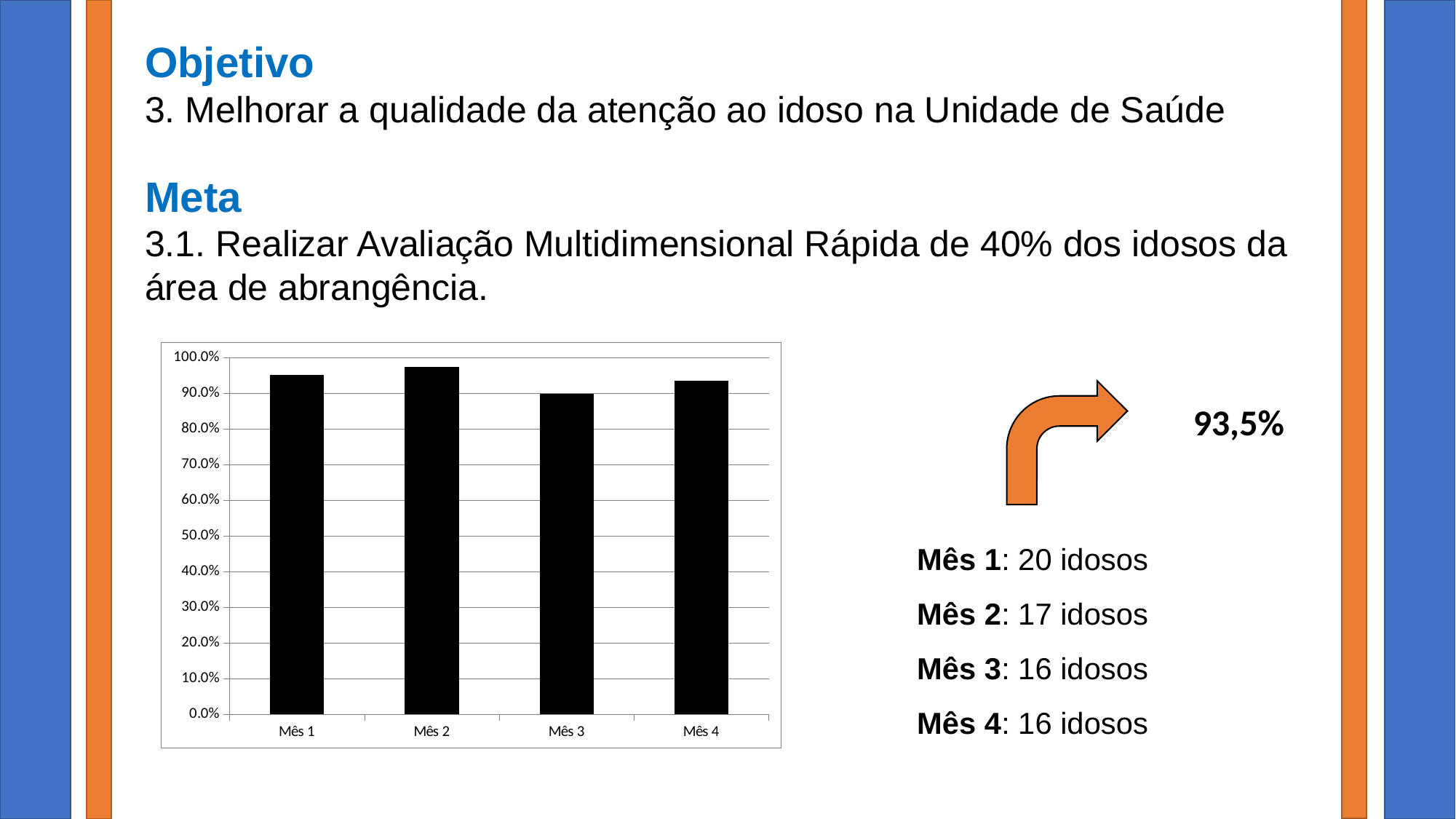
Is the value for Mês 1 greater or less than 90.0%? greater Is the value for Mês 2 greater or less than 100.0%? less What is the highest value shown on the chart's vertical axis? 100.0% Is the value for Mês 4 greater or less than 90.0%? greater Does the value rise or fall from Mês 2 to Mês 3? fall What kind of chart is shown on the slide? bar chart Which month has the highest bar on the chart? Mês 2 Which month has the lowest bar on the chart? Mês 3 What colour are the bars in the chart? black How many categories (months) are plotted on the chart? 4 Which is larger, the value for Mês 2 or the value for Mês 3? Mês 2